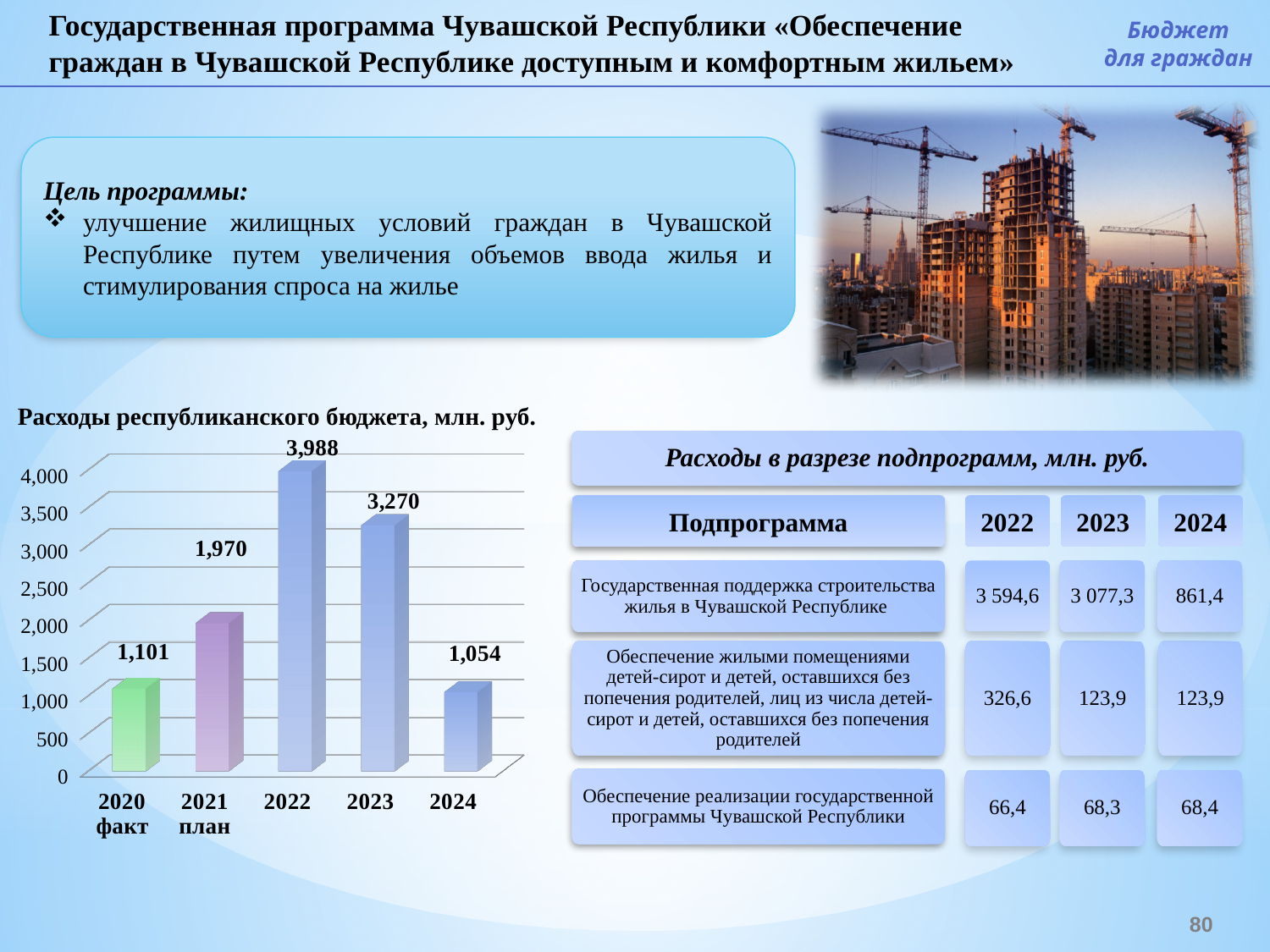
How many bars are shown in the chart? 5 What kind of chart is shown on the slide? bar chart What is the title of the chart on the slide? Расходы республиканского бюджета, млн. руб. What is the value for 2020 факт in the chart? 1,101 Which year has the highest value in the chart? 2022 What is the value for 2024 in the chart? 1,054 What is the value for 2021 план in the chart? 1,970 What is the value for 2022 in the chart 'Расходы республиканского бюджета, млн. руб.'? 3,988 Which year has the lowest value in the chart? 2024 Is the value for 2023 in the chart greater or less than 3,000? greater What is the difference between the values for 2022 and 2023 in the chart? 718 Which is larger in the chart, the value for 2021 план or the value for 2023? 2023